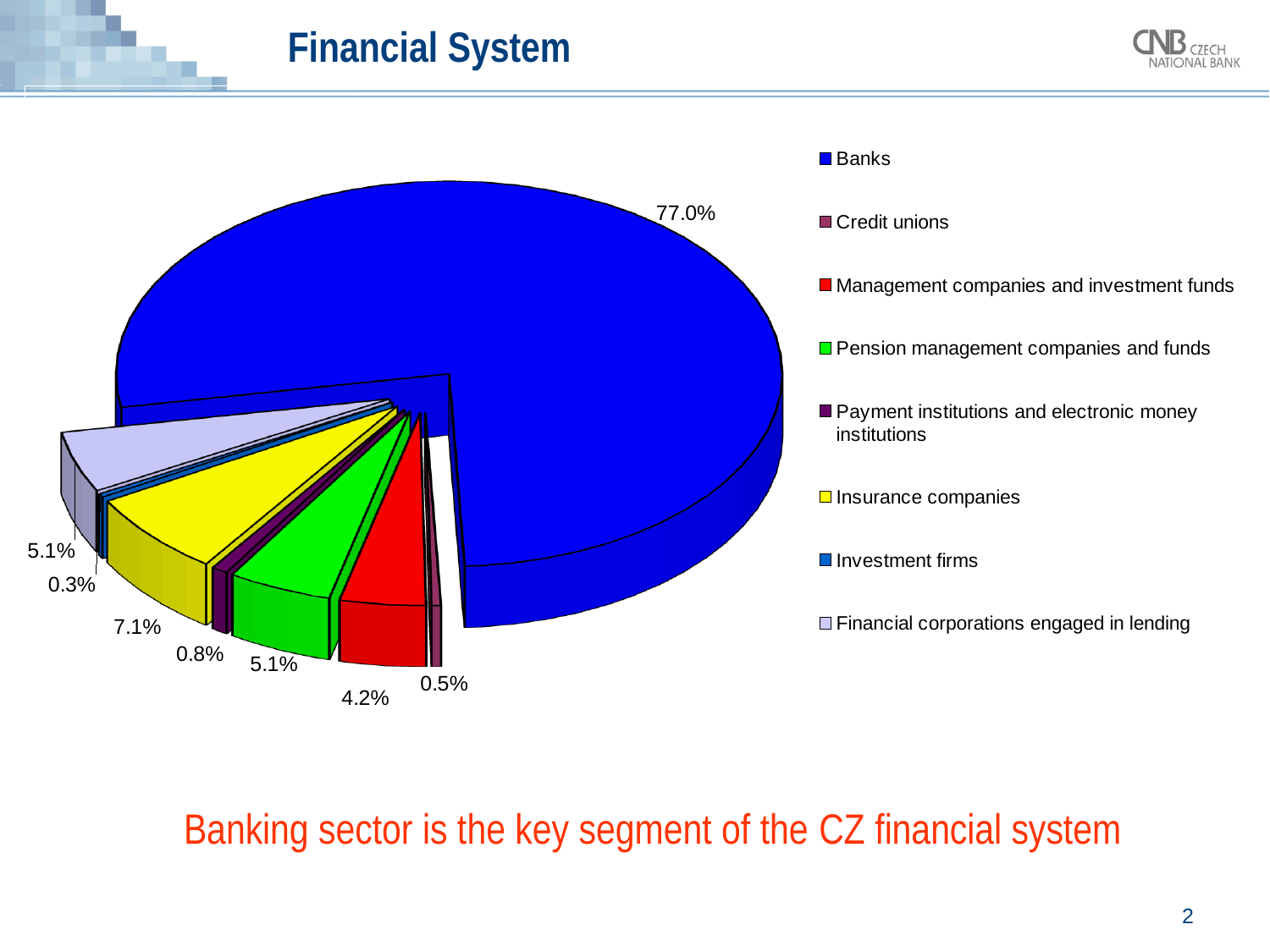
Which segment has the smallest share of the pie chart? Investment firms Which segment has the largest share of the pie chart? Banks What percentage does the pie chart show for Investment firms? 0.3% Which has a larger share: Insurance companies or Pension management companies and funds? Insurance companies What type of chart is shown on the slide? Pie chart How many percentage points larger is the Banks share than the Insurance companies share? 69.9% What percentage does the pie chart show for Payment institutions and electronic money institutions? 0.8% What share of the pie chart is labelled for Banks? 77.0% What percentage does the pie chart show for Insurance companies? 7.1% How many segments does the pie chart have? 8 What colour is the Banks segment in the pie chart? Blue What percentage does the pie chart show for Management companies and investment funds? 4.2%